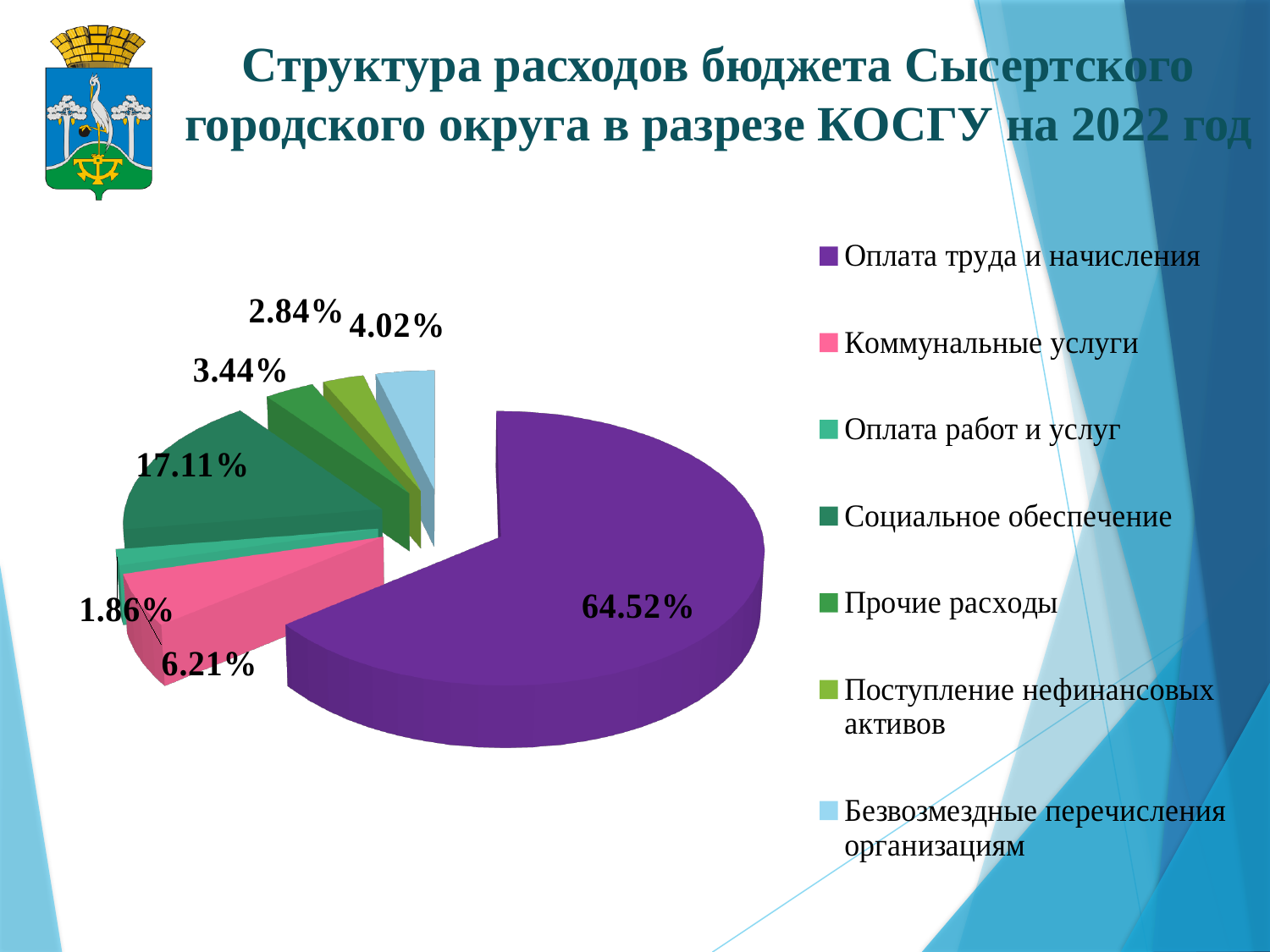
Which category has the largest share of the budget expenditure? Оплата труда и начисления What colour is the slice for Оплата труда и начисления? Purple What share of the budget expenditure is Оплата работ и услуг? 1.86% How many categories does the legend list? 7 What share of the budget expenditure is Безвозмездные перечисления организациям? 4.02% What share of the budget expenditure is Коммунальные услуги? 6.21% Which category has the smallest share of the budget expenditure? Оплата работ и услуг Which is larger: the share for Прочие расходы or the share for Поступление нефинансовых активов? Прочие расходы What share of the budget expenditure is Социальное обеспечение? 17.11% What is the difference between the shares for Социальное обеспечение and Коммунальные услуги? 10.90% What kind of chart is shown on the slide? Pie chart What share of the budget expenditure is Оплата труда и начисления? 64.52%